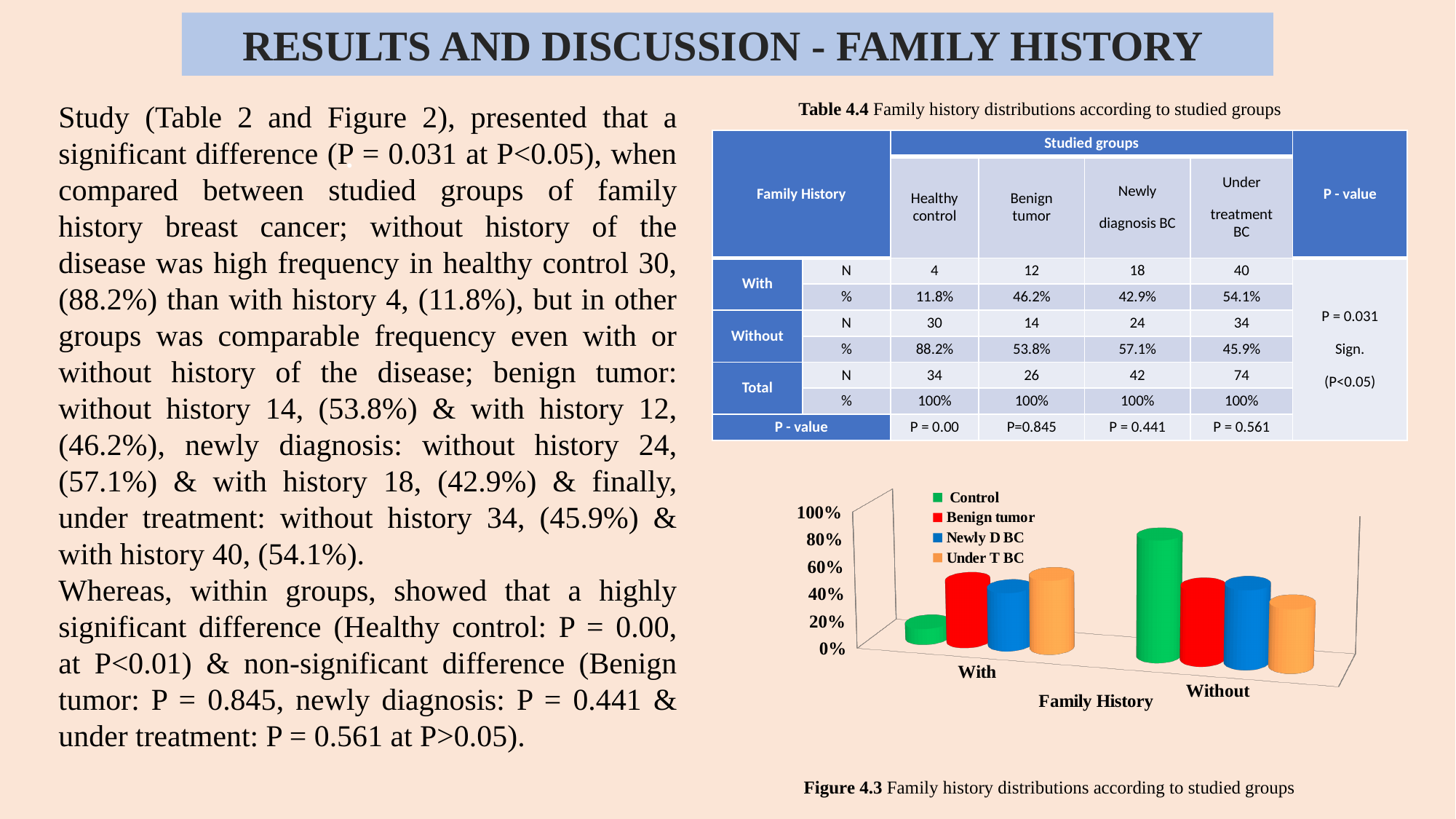
How many categories are shown on the x axis of the chart? 2 In the chart, is the value for Under T BC in the Without category greater or less than 60%? less In the chart, which series has the highest bar in the Without category? Control How many series does the legend of the chart list? 4 In the chart, is the Under T BC bar larger for With or for Without? With In the chart, which series has the highest bar in the With category? Under T BC In the chart, which series has the lowest bar in the With category? Control In the chart, is the Control bar larger for With or for Without? Without In the chart, is the value for Control in the With category greater or less than 20%? less What is the title of the x axis of the chart? Family History In the chart, is the value for Control in the Without category greater or less than 80%? greater What kind of chart is Figure 4.3? bar chart